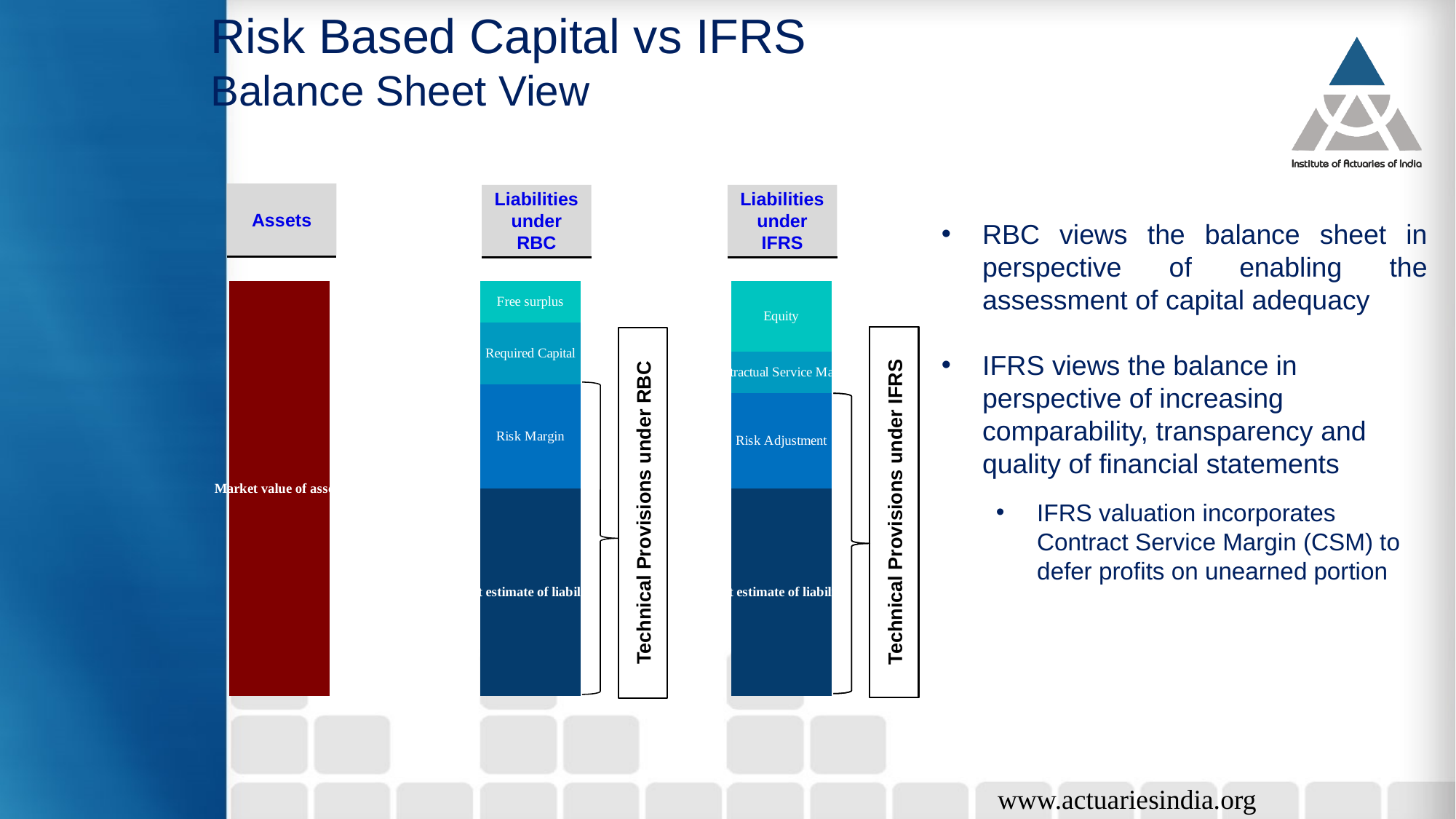
In the Liabilities under RBC bar, which is larger, Risk Margin or Free surplus? Risk Margin How many segments make up the Liabilities under RBC bar? 4 How many segments make up the Liabilities under IFRS bar? 4 In the Liabilities under RBC bar, which segment is the largest? Best estimate of liabilities What label is shown on the vertical box beside the Liabilities under IFRS bar? Technical Provisions under IFRS How many bars are shown on the slide in total? 3 In the Liabilities under RBC bar, which segment is the smallest? Free surplus In the Liabilities under IFRS bar, which segment is the largest? Best estimate of liabilities In the Liabilities under IFRS bar, which segment is at the top? Equity What kind of chart is used to show the Liabilities under RBC? Stacked bar chart In the Liabilities under RBC bar, which is larger, Required Capital or Free surplus? Required Capital